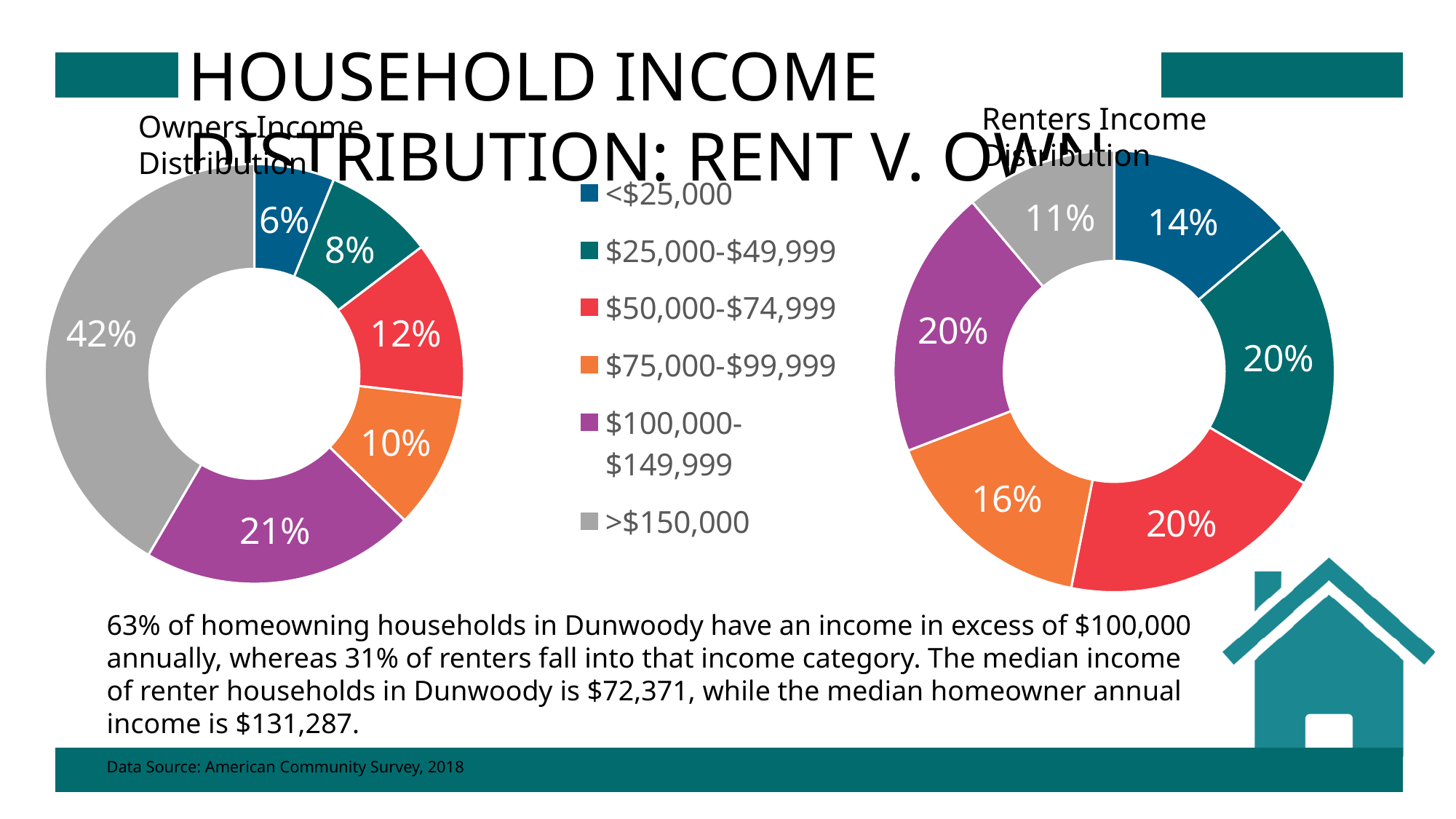
In the Renters Income Distribution chart, which income category has the smallest share? >$150,000 In the Renters Income Distribution chart, what share of households earn $75,000-$99,999? 16% What is the difference between the >$150,000 share in the Owners chart and the >$150,000 share in the Renters chart? 31% In the Owners Income Distribution chart, which income category has the largest share? >$150,000 In the Owners Income Distribution chart, which income category has the smallest share? <$25,000 Which colour represents the $50,000-$74,999 category in the legend? Red In the Owners Income Distribution chart, what is the combined share of the $100,000-$149,999 and >$150,000 categories? 63% In the Renters Income Distribution chart, what share of households earn less than $25,000? 14% What type of chart is the Owners Income Distribution chart? Donut (pie) chart In the Owners Income Distribution chart, what share of households earn more than $150,000? 42% Which is larger: the $75,000-$99,999 share for owners or for renters? Renters How many income categories does the legend list? 6